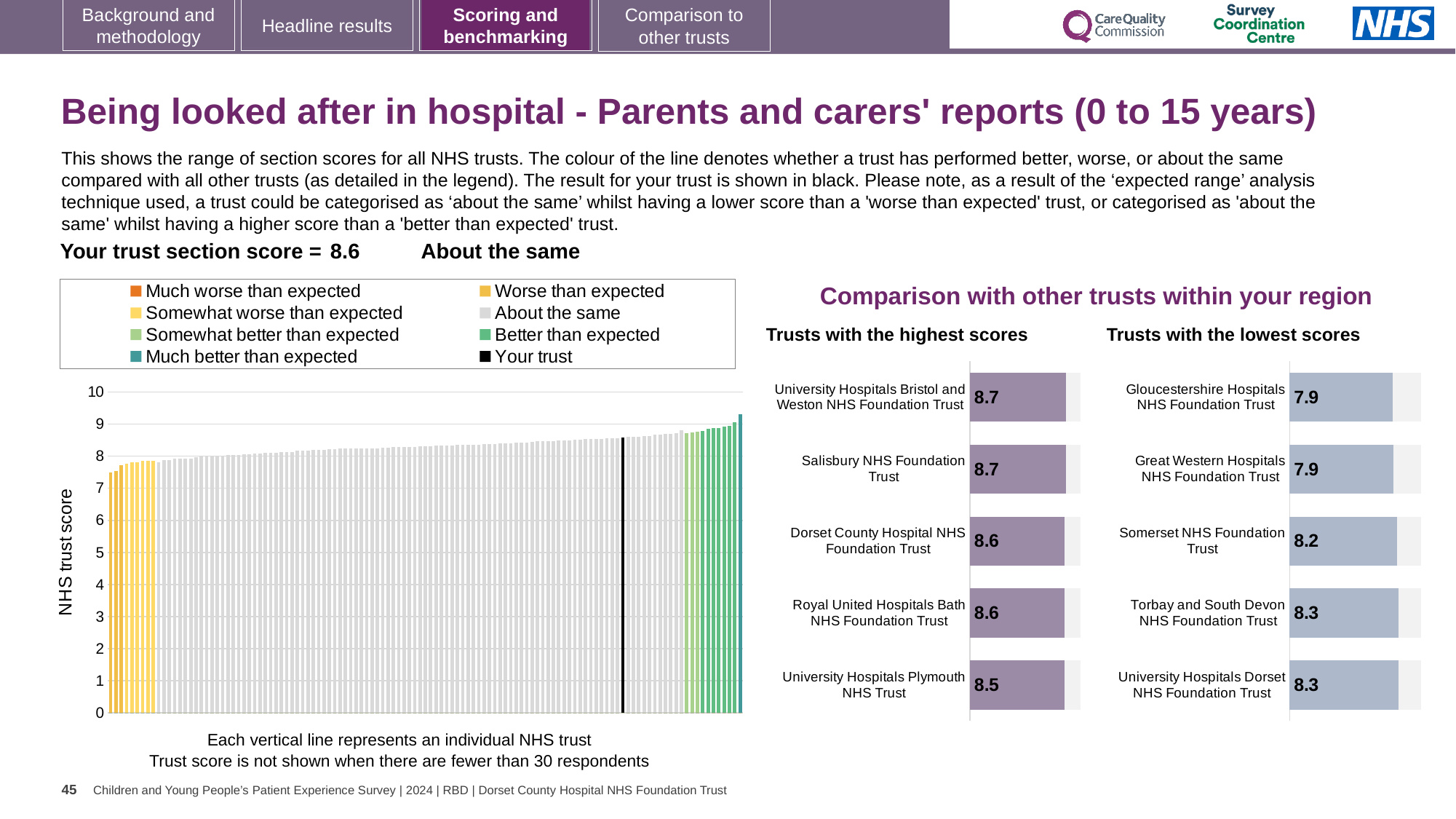
In the 'Trusts with the highest scores' chart, what is the score for Salisbury NHS Foundation Trust? 8.7 In the NHS trust score chart on the left, is the value for 'Your trust' (the black line) greater or less than 8? greater In the 'Trusts with the lowest scores' chart, which has the higher score: Somerset NHS Foundation Trust or Torbay and South Devon NHS Foundation Trust? Torbay and South Devon NHS Foundation Trust How many trusts are listed in the 'Trusts with the highest scores' chart? 5 In the 'Trusts with the highest scores' chart, what is the difference between the score for University Hospitals Bristol and Weston NHS Foundation Trust and the score for University Hospitals Plymouth NHS Trust? 0.2 In the 'Trusts with the lowest scores' chart, what is the score for Somerset NHS Foundation Trust? 8.2 In the NHS trust score chart on the left, do the trust scores rise or fall from left to right? rise How many entries does the legend of the NHS trust score chart on the left list? 8 In the 'Trusts with the lowest scores' chart, what is the difference between the score for University Hospitals Dorset NHS Foundation Trust and the score for Gloucestershire Hospitals NHS Foundation Trust? 0.4 In the 'Trusts with the highest scores' chart, what is the score for University Hospitals Plymouth NHS Trust? 8.5 What kind of chart is the NHS trust score chart on the left of the slide? bar chart In the 'Trusts with the lowest scores' chart, what is the score for Gloucestershire Hospitals NHS Foundation Trust? 7.9